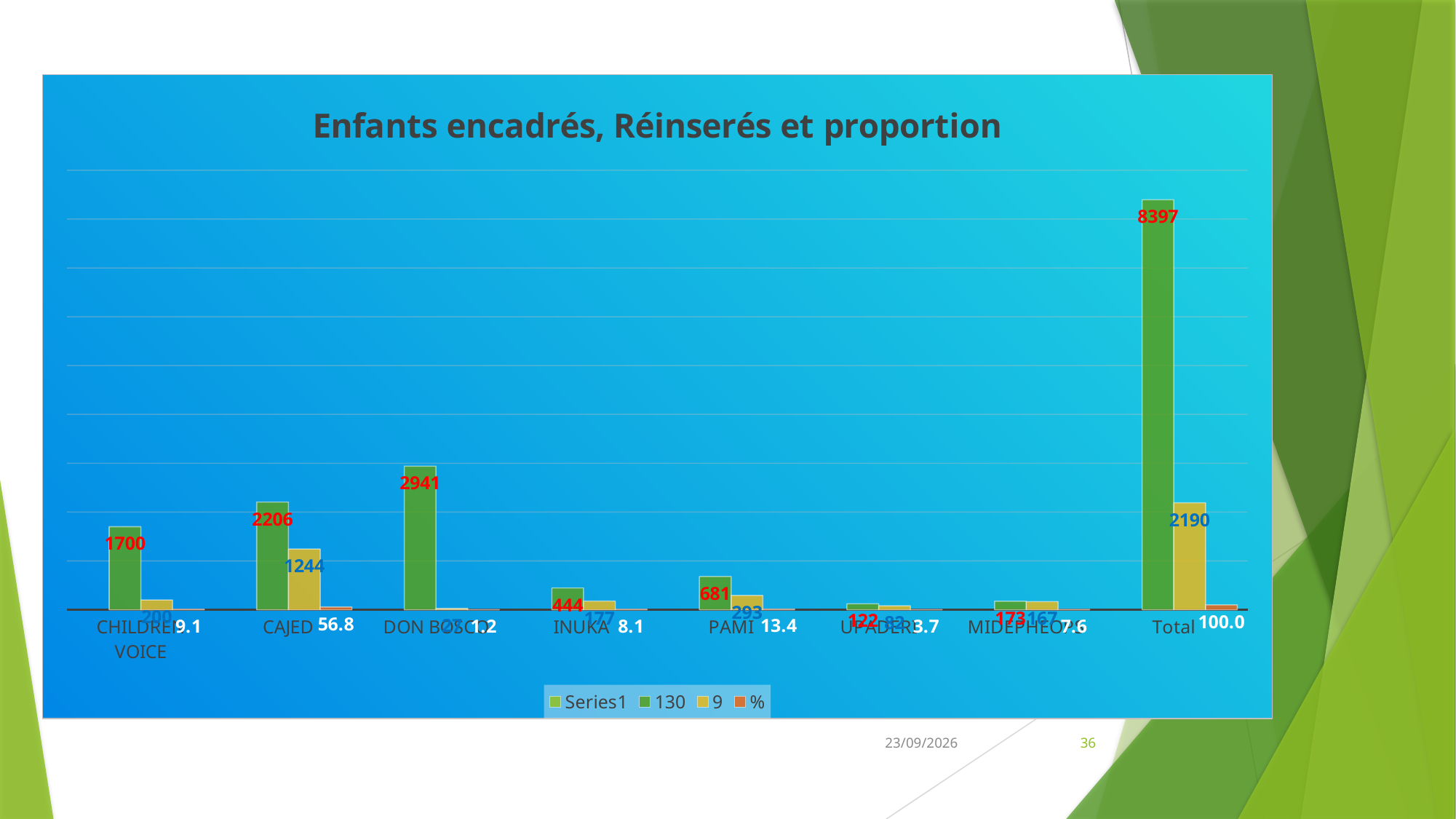
How many series does the legend list? 4 What is the value of the green bar (series 130) for DON BOSCO? 2941 What kind of chart is shown on the slide? bar chart Which has the larger green bar, INUKA or PAMI? PAMI How many categories are shown on the x axis, including Total? 8 What is the value of the yellow bar (series 9) for CAJED? 1244 What is the value of the yellow bar (series 9) for Total? 2190 What is the value of the green bar (series 130) for CAJED? 2206 Which category has the tallest green bar? Total What is the difference between the green bar values for DON BOSCO and CAJED? 735 What is the title of the chart? Enfants encadrés, Réinserés et proportion What is the % value shown for CAJED? 56.8